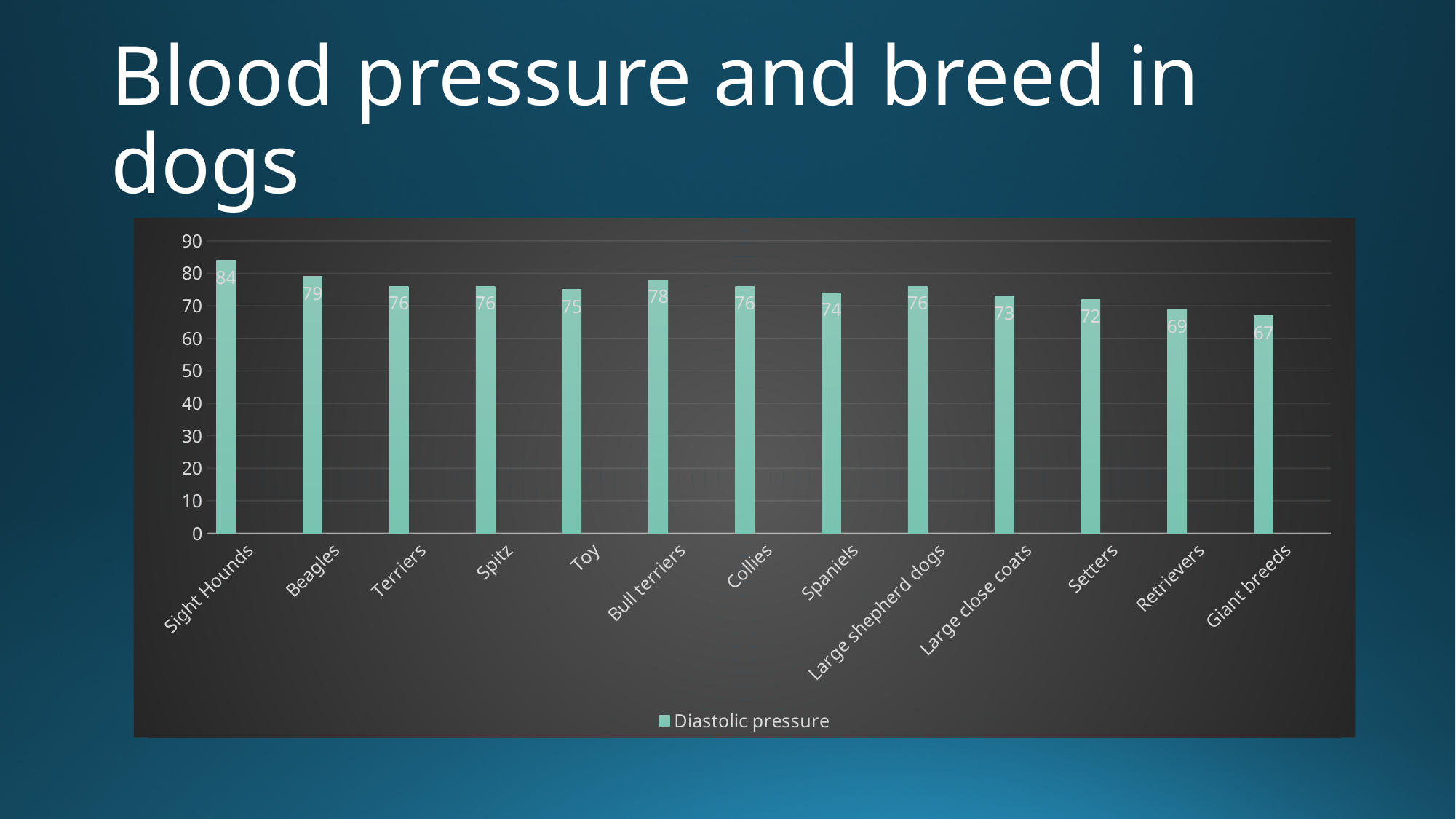
Which breed has the highest diastolic pressure? Sight Hounds What is the difference in diastolic pressure between Sight Hounds and Giant breeds? 17 Which has a higher diastolic pressure, Beagles or Retrievers? Beagles How many breed categories are shown on the chart? 13 What kind of chart is shown on the slide? bar chart What is the name of the series shown in the legend? Diastolic pressure What is the diastolic pressure value for Beagles? 79 What is the diastolic pressure value for Bull terriers? 78 How many series does the legend list? 1 Which breed has the lowest diastolic pressure? Giant breeds What is the diastolic pressure value for Giant breeds? 67 Is the diastolic pressure for Setters greater or less than 80? less